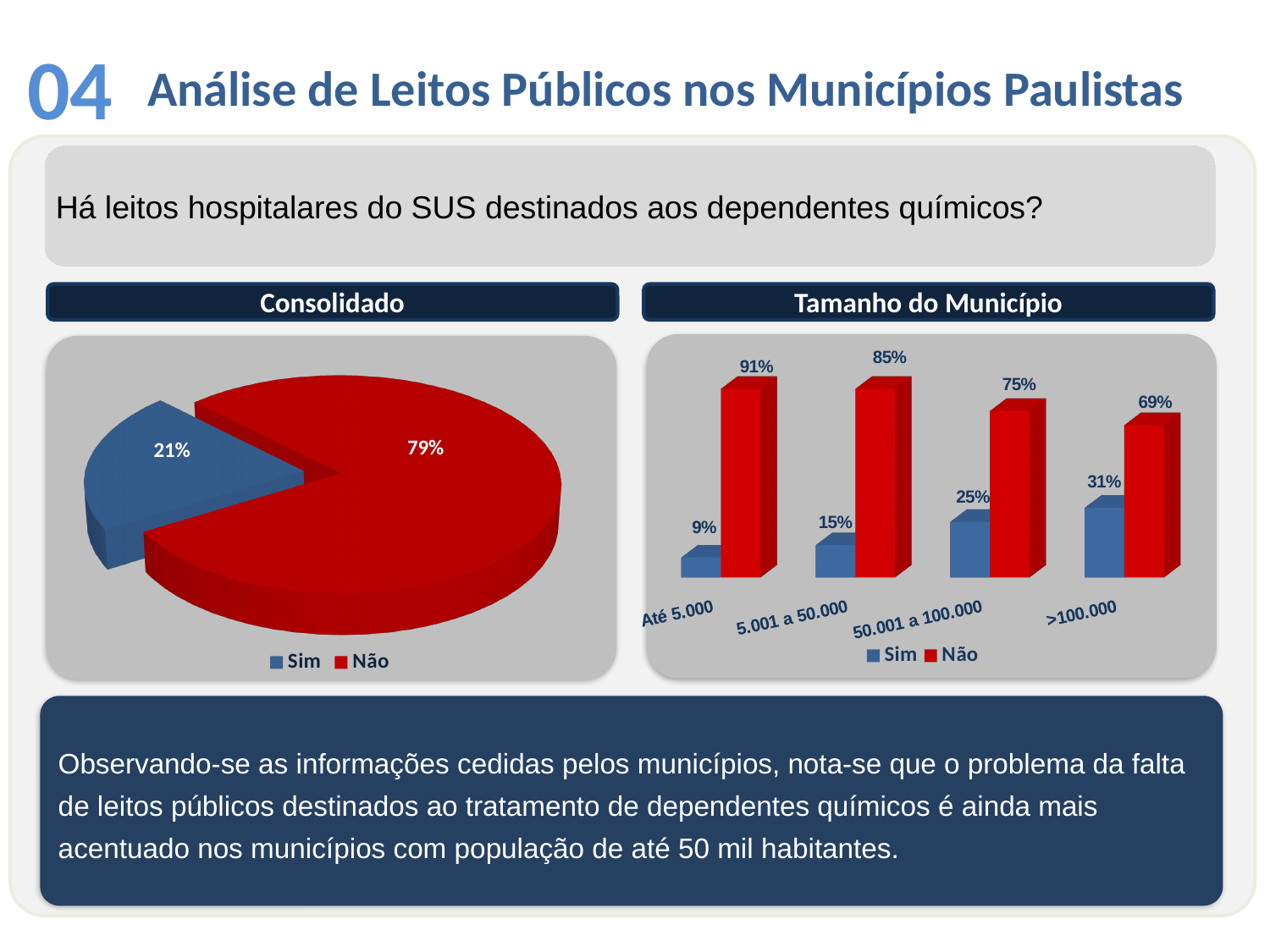
In the 'Tamanho do Município' chart, what is the 'Sim' value for '>100.000'? 31% In the 'Tamanho do Município' chart, which category has the highest 'Não' value? Até 5.000 In the 'Tamanho do Município' chart, how do the 'Sim' values change from 'Até 5.000' to '>100.000'? They rise In the 'Consolidado' pie chart, what percentage is shown for 'Sim'? 21% In the 'Tamanho do Município' chart, what is the 'Sim' value for '50.001 a 100.000'? 25% In the 'Tamanho do Município' chart, what is the difference between the 'Não' values for '5.001 a 50.000' and '>100.000'? 16% In the 'Consolidado' pie chart, what percentage is shown for 'Não'? 79% What kind of chart is the 'Tamanho do Município' chart? Bar chart In the 'Tamanho do Município' chart, which category has the lowest 'Sim' value? Até 5.000 In the 'Consolidado' chart, which slice is larger, 'Sim' or 'Não'? Não In the 'Tamanho do Município' chart, what is the 'Não' value for 'Até 5.000'? 91% What kind of chart is the 'Consolidado' chart? Pie chart